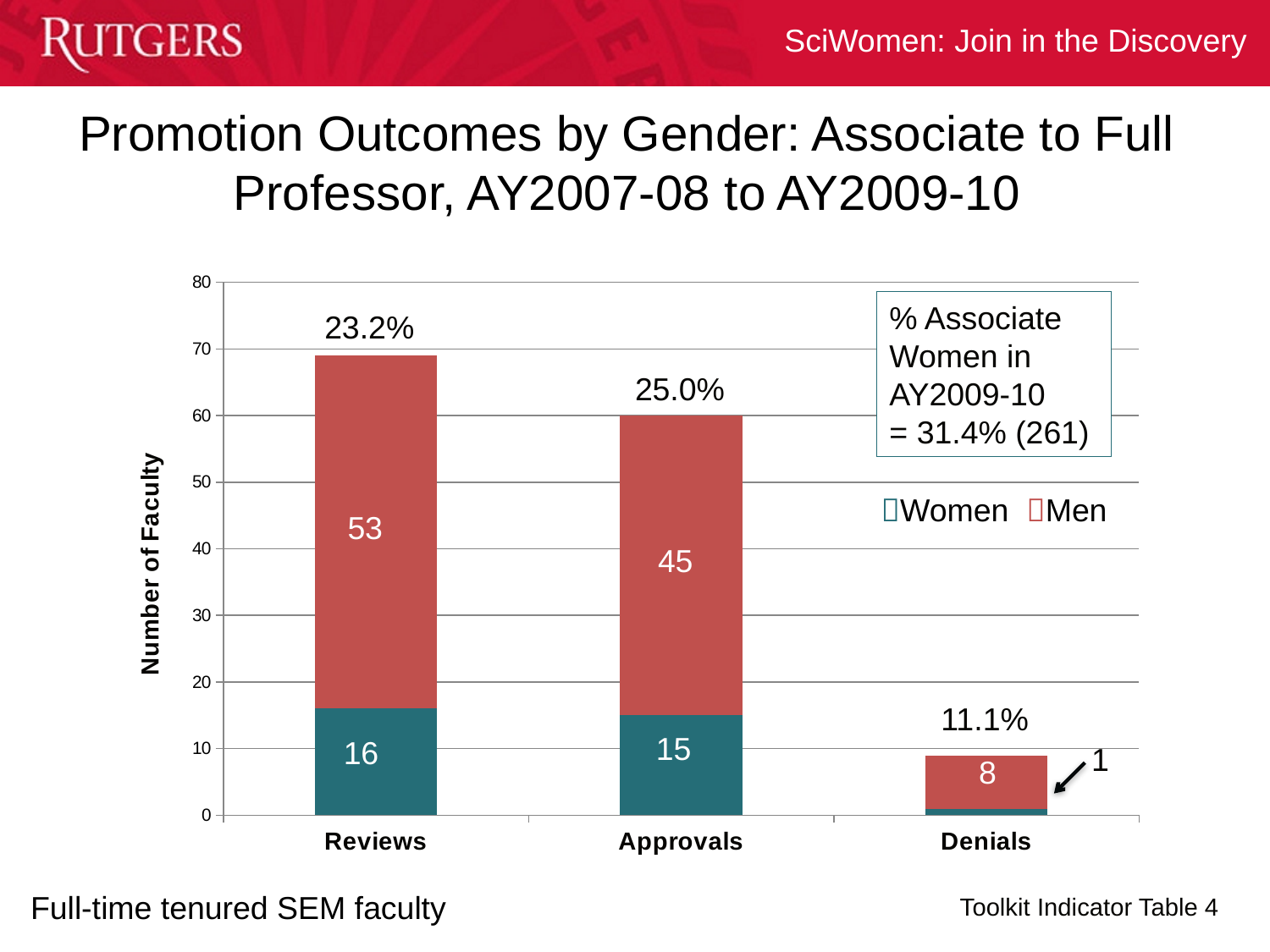
How many women received approvals according to the chart? 15 What is the difference between the number of men and women in the Approvals category? 30 What is the label of the y-axis? Number of Faculty How many women were denied promotion according to the chart? 1 How many series does the legend list? 2 What is the total number of faculty in the Reviews bar? 69 Which category has the highest total number of faculty? Reviews What is the total number of faculty in the Denials bar? 9 How many men were reviewed for promotion according to the chart? 53 What percentage label is shown above the Approvals bar? 25.0% Which category has the lowest total number of faculty? Denials What type of chart is shown on the slide? Stacked bar chart